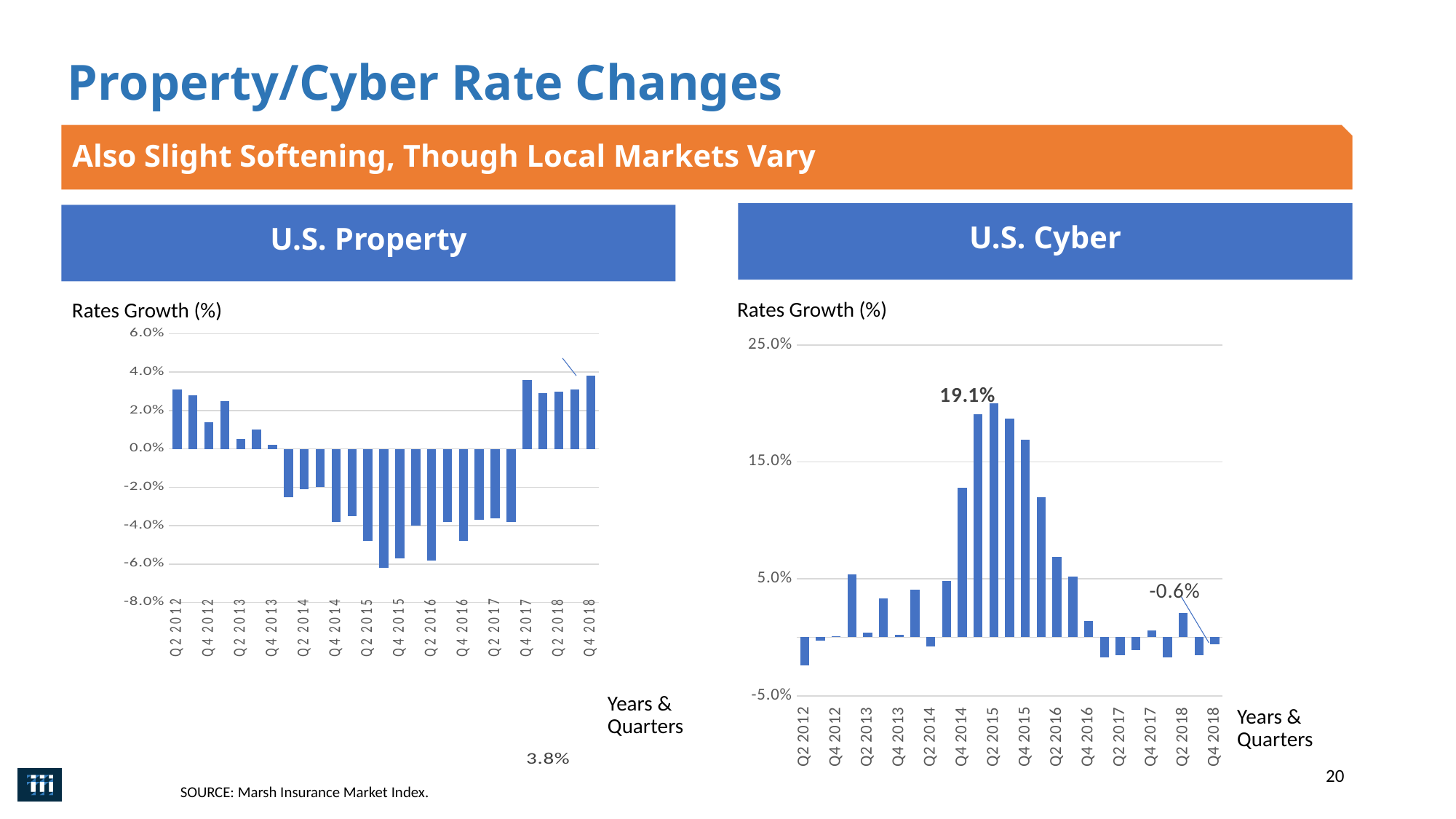
On the U.S. Property chart, is the value for Q2 2015 greater or less than -4.0%? less On the U.S. Cyber chart, do the values rise or fall from Q2 2015 to Q4 2016? fall On the U.S. Cyber chart, what is the rates growth value for Q4 2018? -0.6% On the U.S. Property chart, which is larger, the value for Q2 2012 or the value for Q2 2013? Q2 2012 What is the source cited for the charts on the slide? Marsh Insurance Market Index On the U.S. Cyber chart, what is the highest rates growth value labeled? 19.1% On the U.S. Property chart, what is the rates growth value for Q4 2018? 3.8% What kind of chart is the U.S. Property chart? bar chart On the U.S. Cyber chart, is the value for Q4 2014 greater or less than 15.0%? less On the U.S. Cyber chart, which quarter has the highest rates growth? Q2 2015 On the U.S. Property chart, is the value for Q2 2012 greater or less than 2.0%? greater